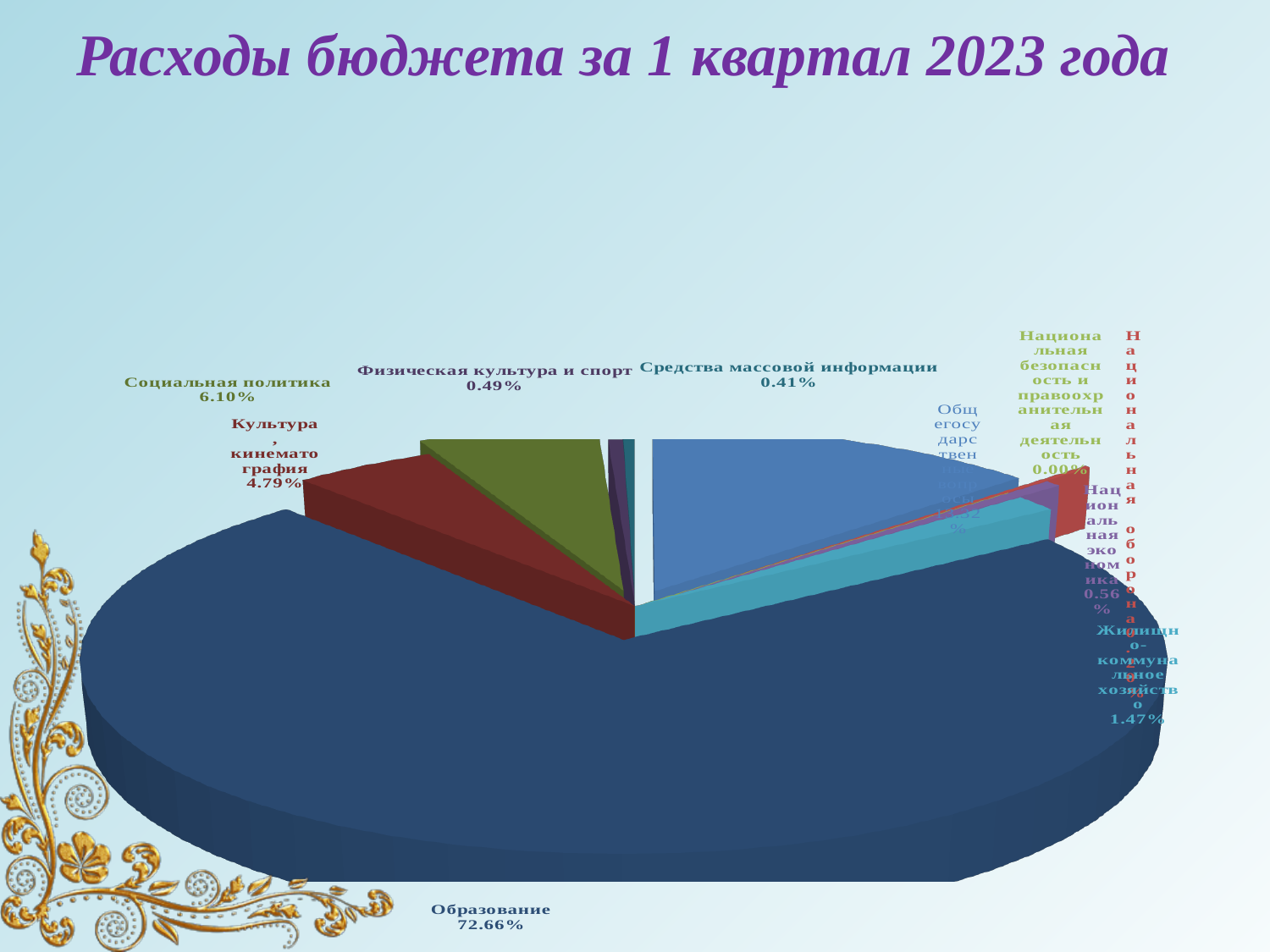
What is the difference between the values for Социальная политика and Культура, кинематография? 1.31% What kind of chart is shown on the slide? pie chart What is the value shown for Физическая культура и спорт? 0.49% What is the title of the chart? Расходы бюджета за 1 квартал 2023 года What share of the budget expenses goes to Образование? 72.66% What is the value shown for Национальная экономика? 0.56% What is the value shown for Социальная политика? 6.10% Which category has the largest share of the pie? Образование What is the value shown for Средства массовой информации? 0.41% What is the value shown for Культура, кинематография? 4.79% What is the value shown for Жилищно-коммунальное хозяйство? 1.47% Which category has the smallest share, with a value of 0.00%? Национальная безопасность и правоохранительная деятельность